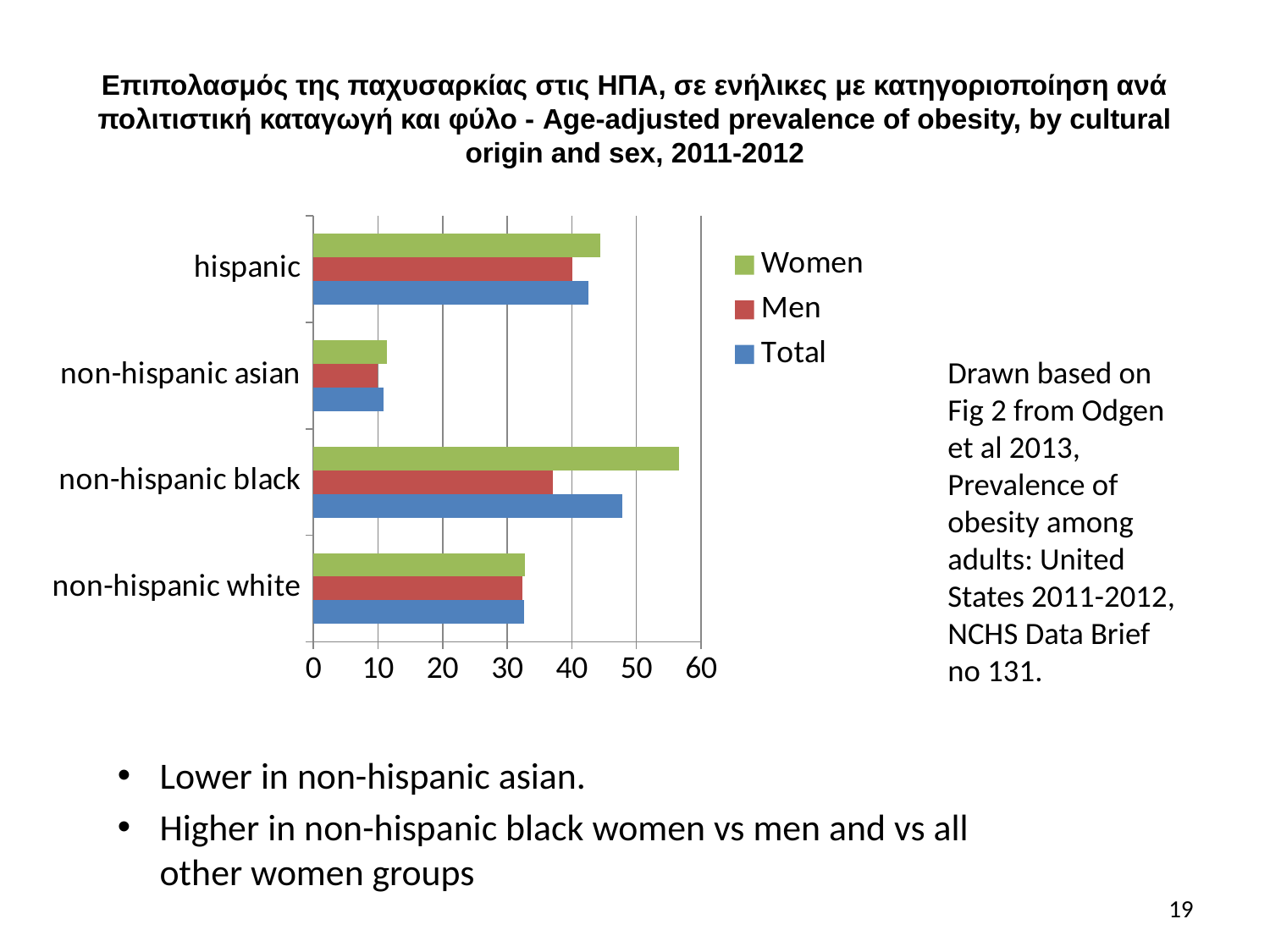
Which is larger for Men: hispanic or non-hispanic white? hispanic How many cultural origin categories are shown on the chart? 4 Is the value for Women in hispanic greater or less than 40? greater What kind of chart is shown on the slide? bar chart Which colour represents the Total series in the legend? blue Is the value for Men in non-hispanic black greater or less than 30? greater Which category has the lowest value for Total? non-hispanic asian Is the value for Women in non-hispanic black greater or less than 50? greater How many series does the legend list? 3 Which is larger for non-hispanic black: the value for Women or the value for Men? Women Which category has the highest value for Women? non-hispanic black